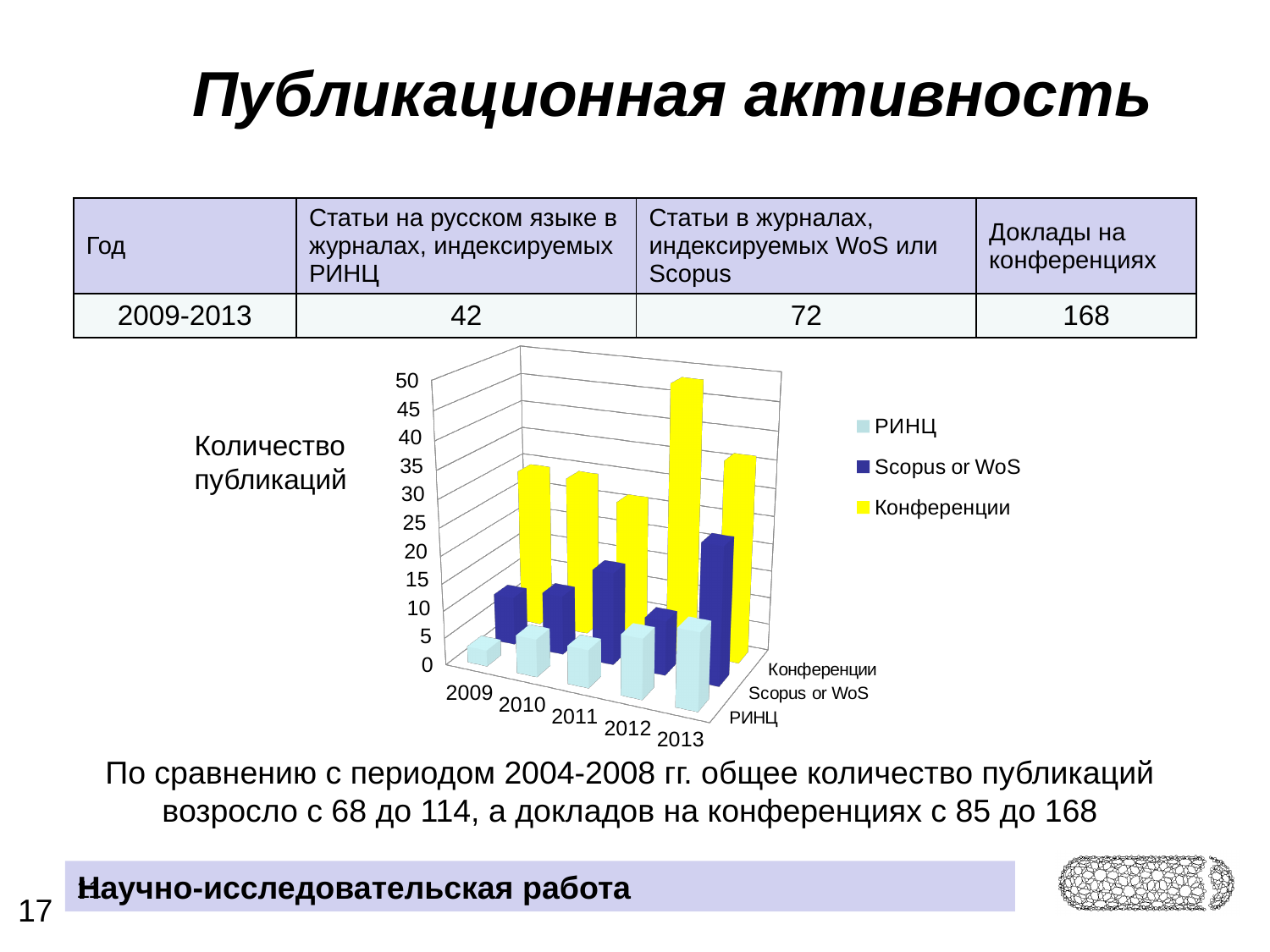
What kind of chart is shown on the slide? bar chart Is the value for Scopus or WoS in 2013 greater or less than 15? greater How many series does the chart legend list? 3 Is the value for Конференции in 2012 greater or less than 40? greater In 2013, which series has the larger value: Scopus or WoS, or РИНЦ? Scopus or WoS Which year has the highest value for the Scopus or WoS series? 2013 Which year has the highest value for the Конференции series? 2012 What is the label of the vertical axis of the chart? Количество публикаций Which year has the highest value for the РИНЦ series? 2013 How many years are shown on the x axis of the chart? 5 Is the value for РИНЦ in 2009 greater or less than 10? less